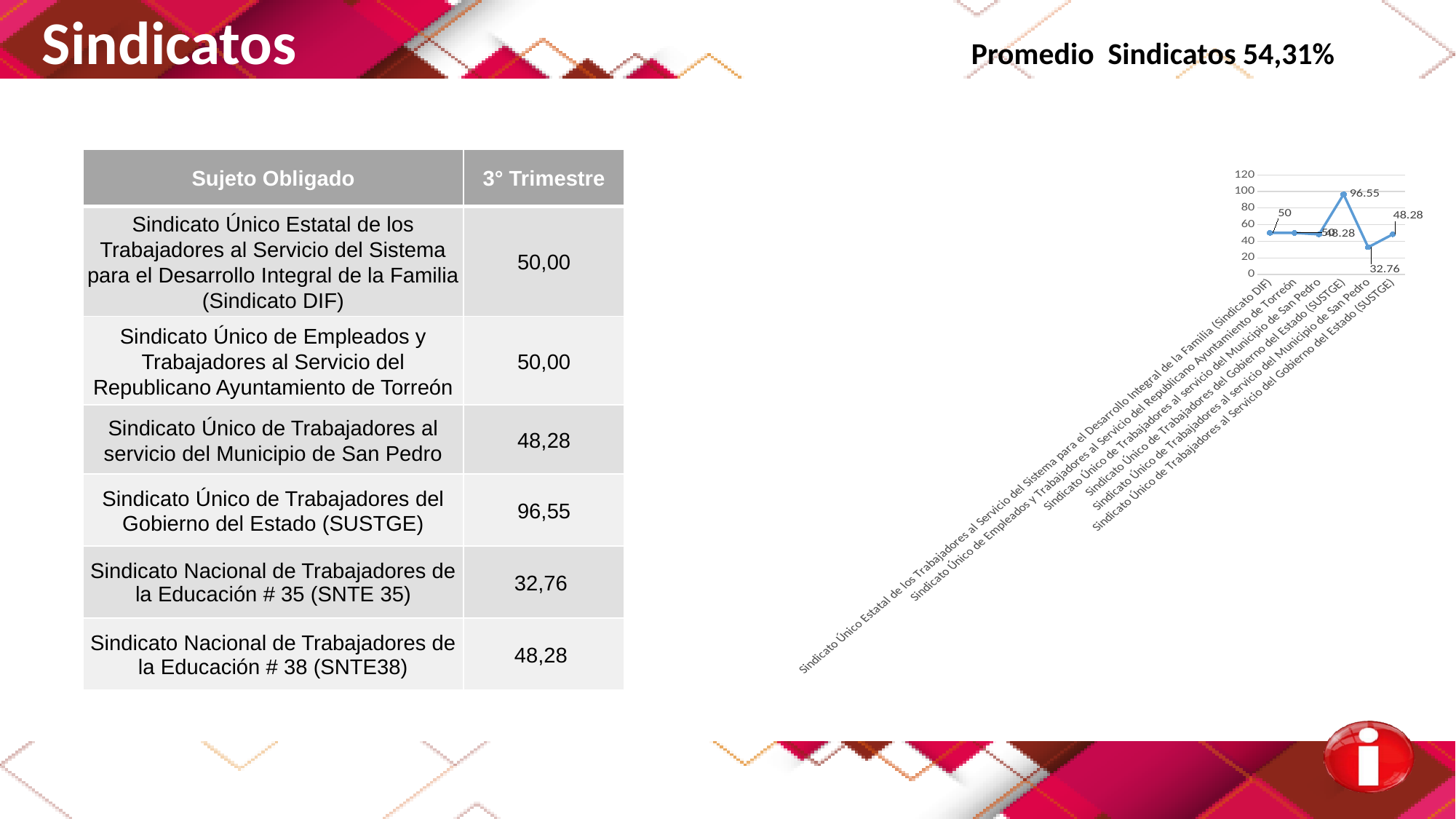
On the line chart, what is the value for Sindicato Único de Trabajadores del Gobierno del Estado (SUSTGE)? 96.55 Which category has the highest value on the line chart? Sindicato Único de Trabajadores del Gobierno del Estado (SUSTGE) On the line chart, what is the value for Sindicato Único Estatal de los Trabajadores al Servicio del Sistema para el Desarrollo Integral de la Familia (Sindicato DIF)? 50 On the line chart, is the value for Sindicato Único de Trabajadores del Gobierno del Estado (SUSTGE) greater or less than 80? greater What is the lowest value plotted on the line chart? 32.76 On the line chart, what is the difference between the highest value (96.55) and the lowest value (32.76)? 63.79 What kind of chart is shown on the right of the slide? line chart How many data points are plotted on the line chart? 6 What is the maximum value shown on the vertical axis of the line chart? 120 On the line chart, what is the value of the fifth data point? 32.76 On the line chart, what is the value of the last (sixth) data point? 48.28 On the line chart, which is larger: the first data point or the last data point? the first data point